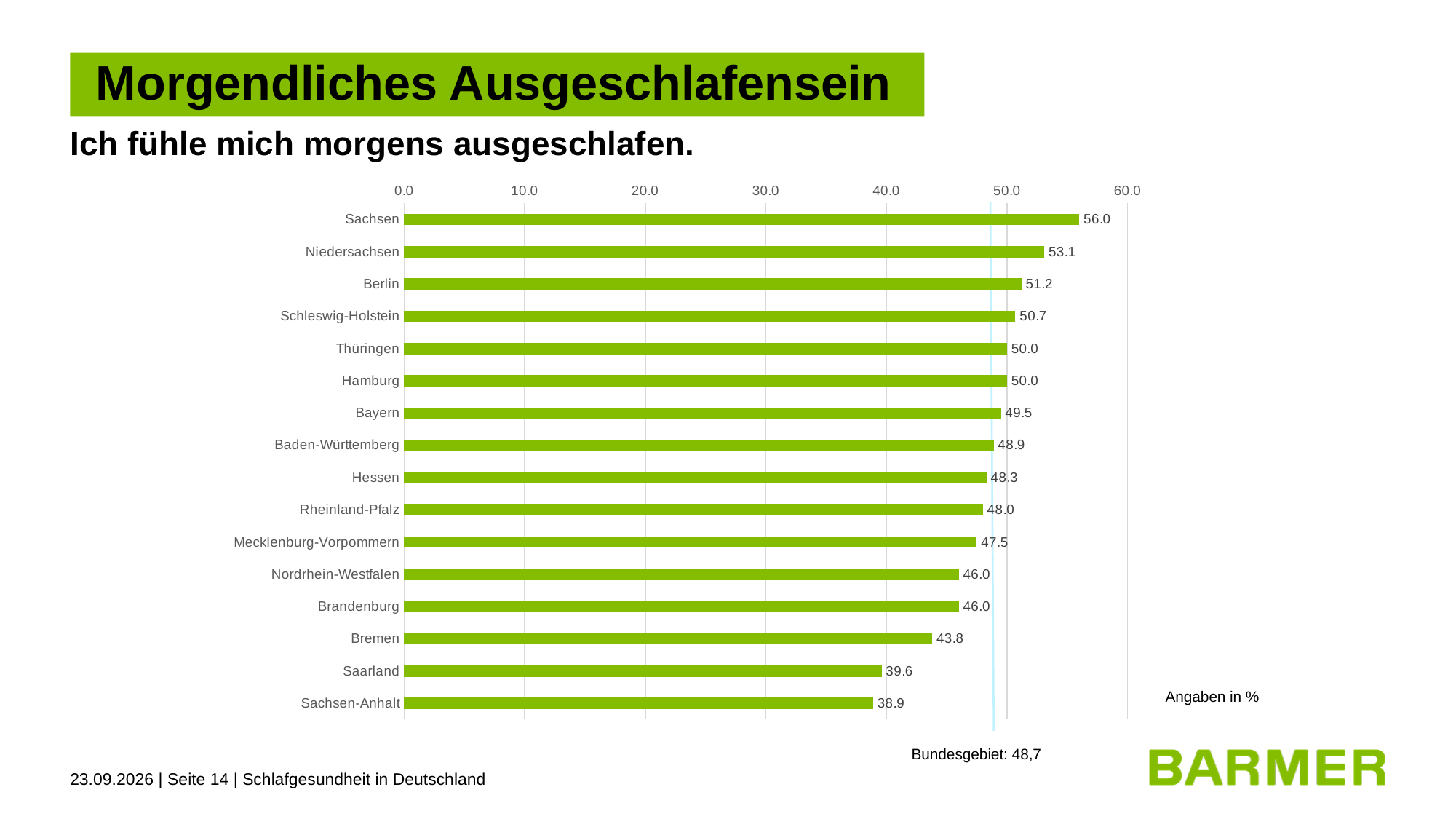
What is the value for Sachsen? 56.0 Which is larger, the value for Hessen or the value for Saarland? Hessen What is the value for Bremen? 43.8 What value is given for Bundesgebiet below the chart? 48,7 What is the difference between the values for Niedersachsen and Berlin? 1.9 Which category has the lowest value? Sachsen-Anhalt Is the value for Bayern greater or less than 40.0? greater How many categories are shown in the chart? 16 What is the value for Mecklenburg-Vorpommern? 47.5 Which category has the highest value? Sachsen What is the difference between the values for Sachsen and Sachsen-Anhalt? 17.1 What kind of chart is shown on the slide? bar chart